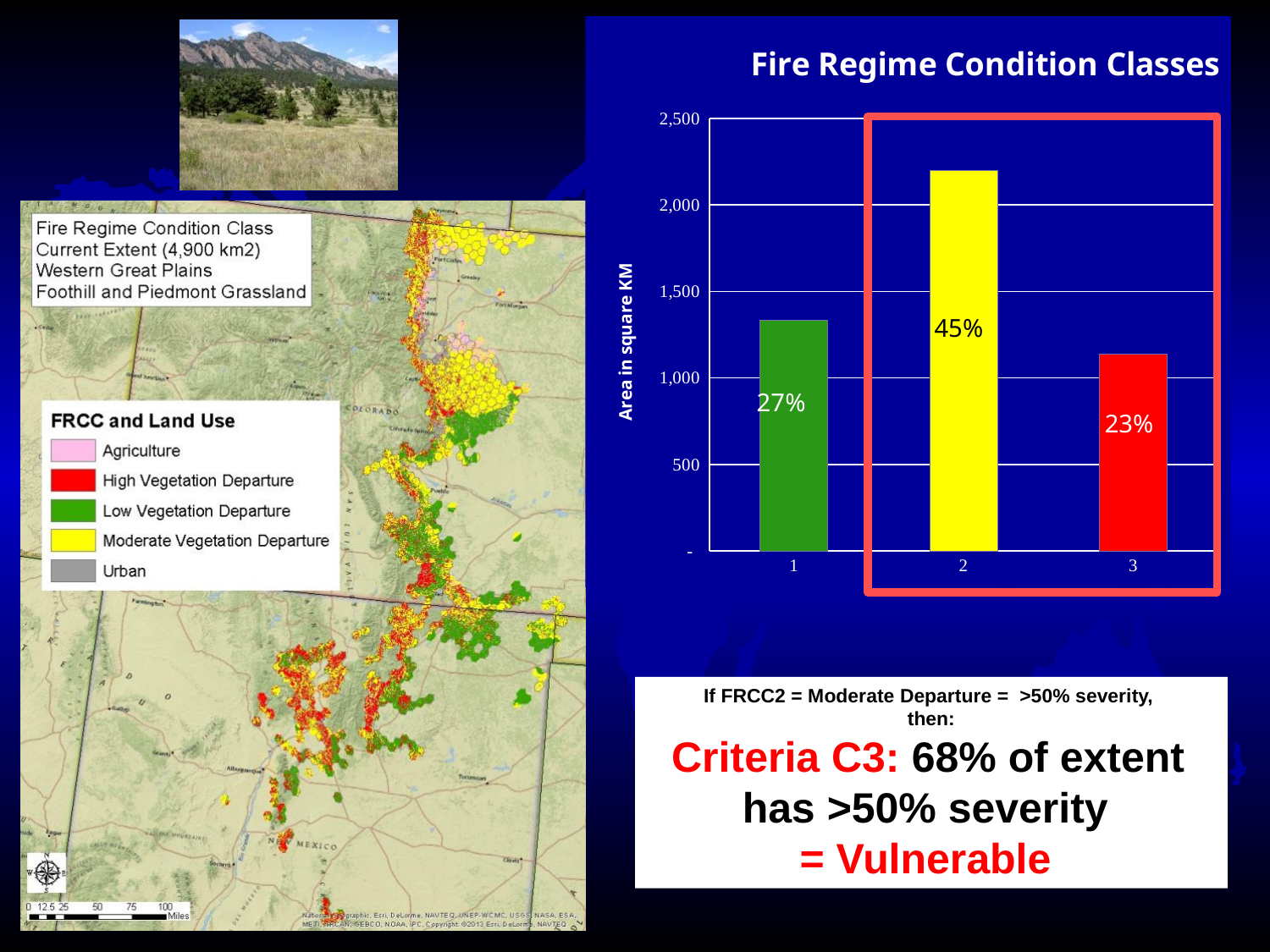
Which bar is taller, category 1 or category 3? 1 What is the data label shown on the bar for category 2? 45% Is the value for category 1 greater or less than 1,000? greater Which category has the tallest bar? 2 Is the value for category 3 greater or less than 1,500? less What kind of chart is shown? bar chart Is the value for category 2 greater or less than 2,000? greater What is the label of the y axis? Area in square KM How many categories are shown on the x axis? 3 What is the data label shown on the bar for category 3? 23% Which category has the shortest bar? 3 What is the data label shown on the bar for category 1? 27%